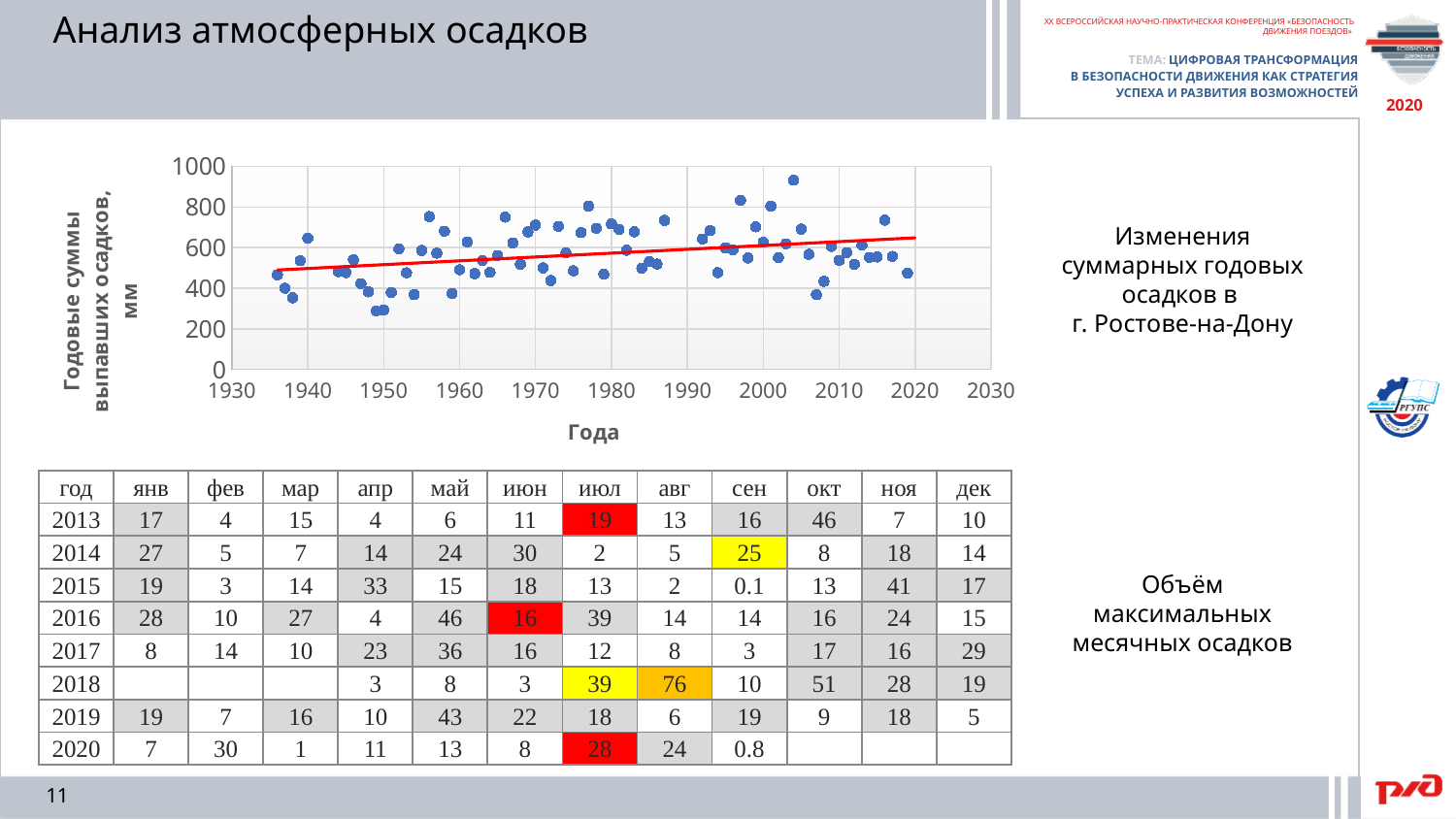
Is the lowest plotted annual precipitation value greater or less than 200 mm? greater What is the title of the vertical axis of the chart? Годовые суммы выпавших осадков, мм Is the value of the highest point in the 1950s greater or less than 600 mm? greater Is the lowest plotted annual precipitation value greater or less than 400 mm? less Do the annual precipitation values generally rise or fall along the x axis according to the trend line? rise What is the first year label shown on the horizontal axis? 1930 What kind of chart is shown on the slide? scatter chart What is the title of the horizontal axis of the chart? Года